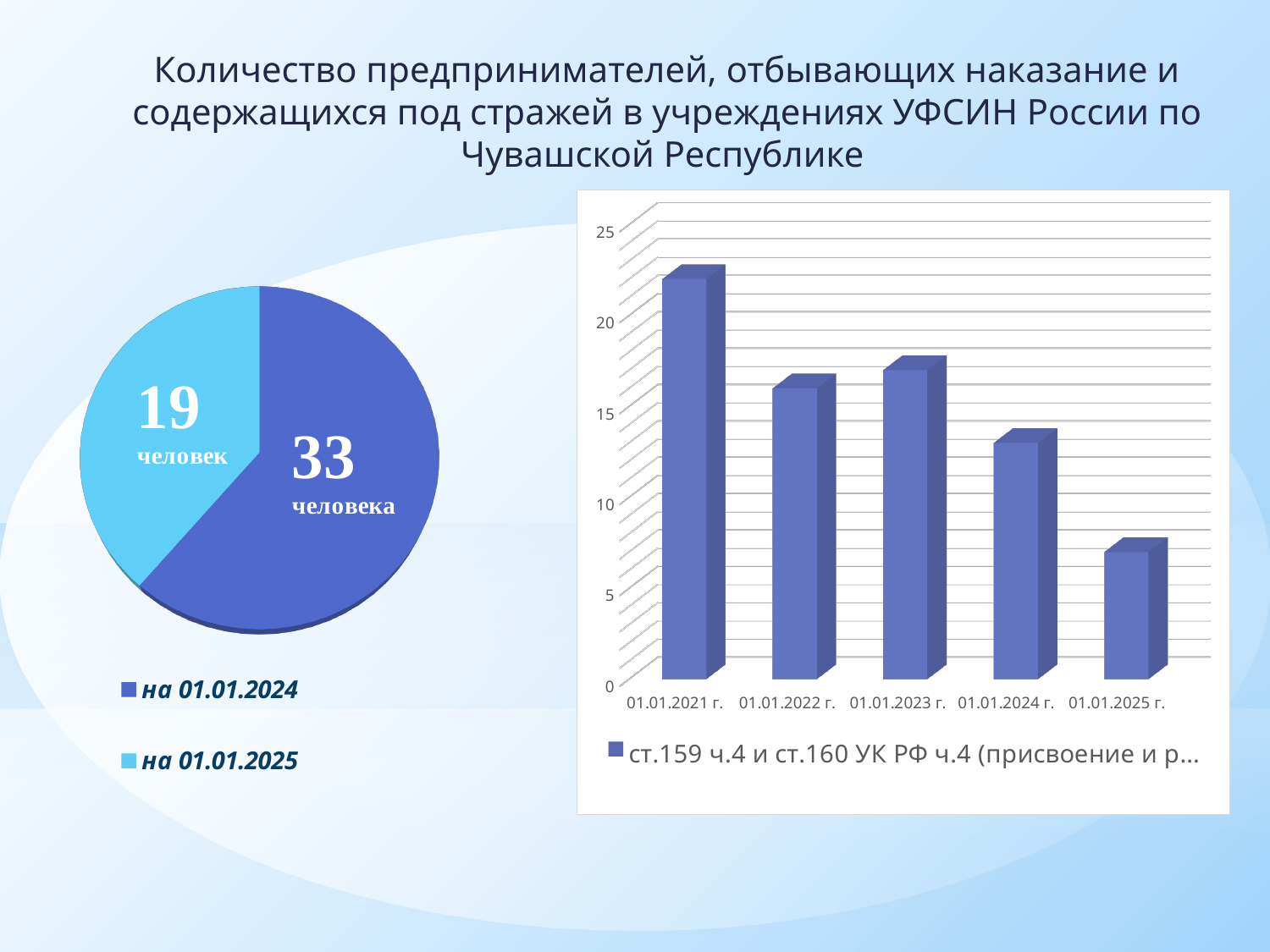
In the bar chart on the right, which category has the lowest bar? 01.01.2025 г. In the pie chart on the left, what is the value for на 01.01.2025? 19 человек In the pie chart on the left, how many slices are there? 2 What kind of chart is the chart on the left of the slide? pie chart What kind of chart is the chart on the right of the slide? bar chart In the bar chart on the right, which category has the highest bar? 01.01.2021 г. In the bar chart on the right, is the value for 01.01.2021 г. greater or less than 20? greater In the bar chart on the right, how many categories are shown on the x axis? 5 In the pie chart on the left, what is the difference between the value for на 01.01.2024 and the value for на 01.01.2025? 14 In the pie chart on the left, which slice is larger: на 01.01.2024 or на 01.01.2025? на 01.01.2024 In the bar chart on the right, is the value for 01.01.2025 г. greater or less than 10? less In the pie chart on the left, what is the value for на 01.01.2024? 33 человека